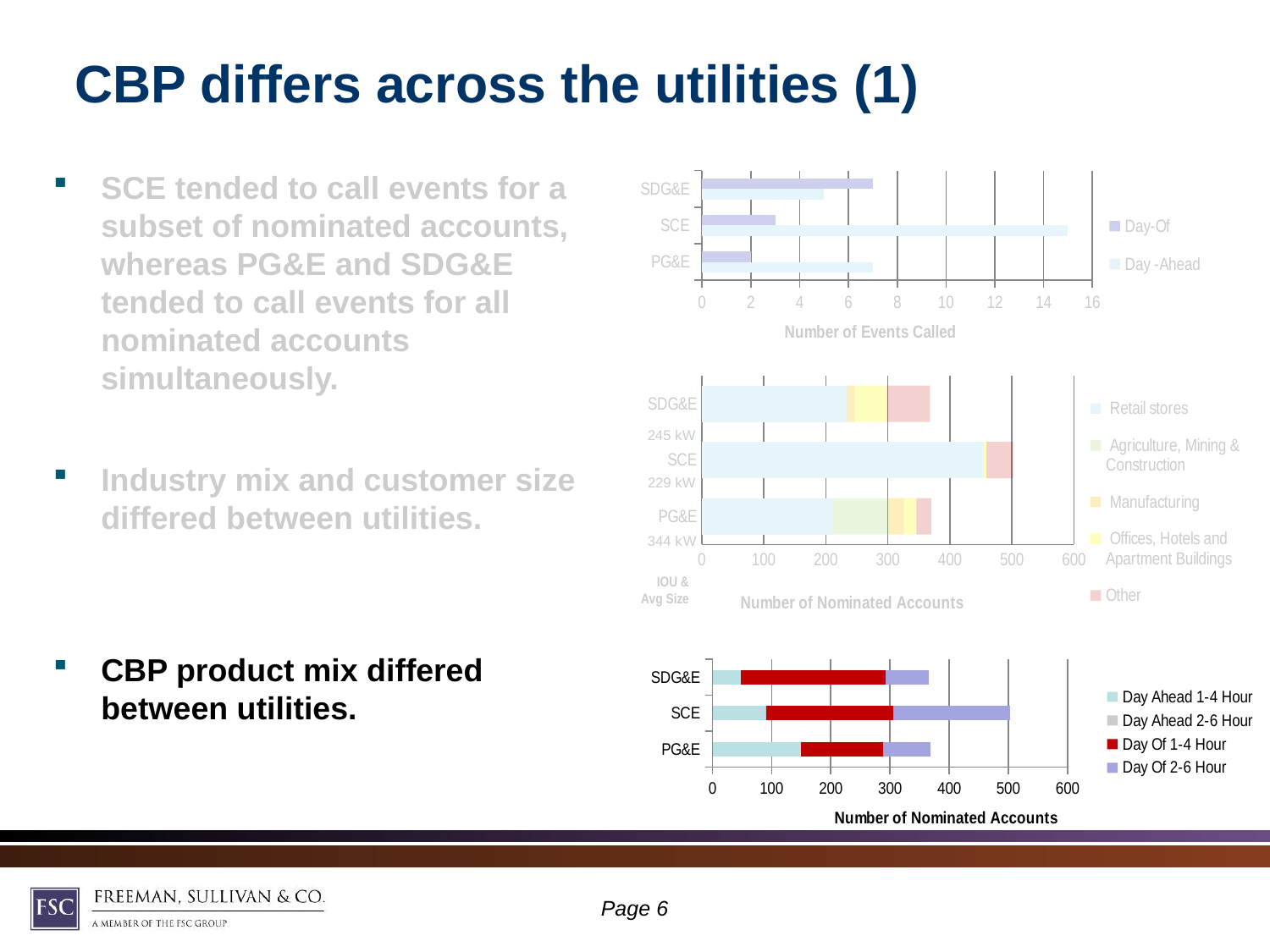
In the bottom chart (Number of Nominated Accounts by product), is the total bar for SCE greater or less than 400? greater In the top chart (Number of Events Called), how many utilities are shown on the y axis? 3 In the top chart (Number of Events Called), is the Day-Of value for PG&E greater or less than 4? less In the top chart (Number of Events Called), which utility has the highest number of Day-Ahead events? SCE In the middle chart (Number of Nominated Accounts by industry), is the Retail stores value for SDG&E greater or less than 300? less In the bottom chart (Number of Nominated Accounts by product), how many series does the legend list? 4 In the top chart (Number of Events Called), which is larger for SDG&E: Day-Of or Day-Ahead? Day-Of In the middle chart (Number of Nominated Accounts by industry), which utility has the longest total bar? SCE What kind of chart is the top chart titled 'Number of Events Called'? bar chart In the top chart (Number of Events Called), how many series does the legend list? 2 In the middle chart (Number of Nominated Accounts by industry), how many series does the legend list? 5